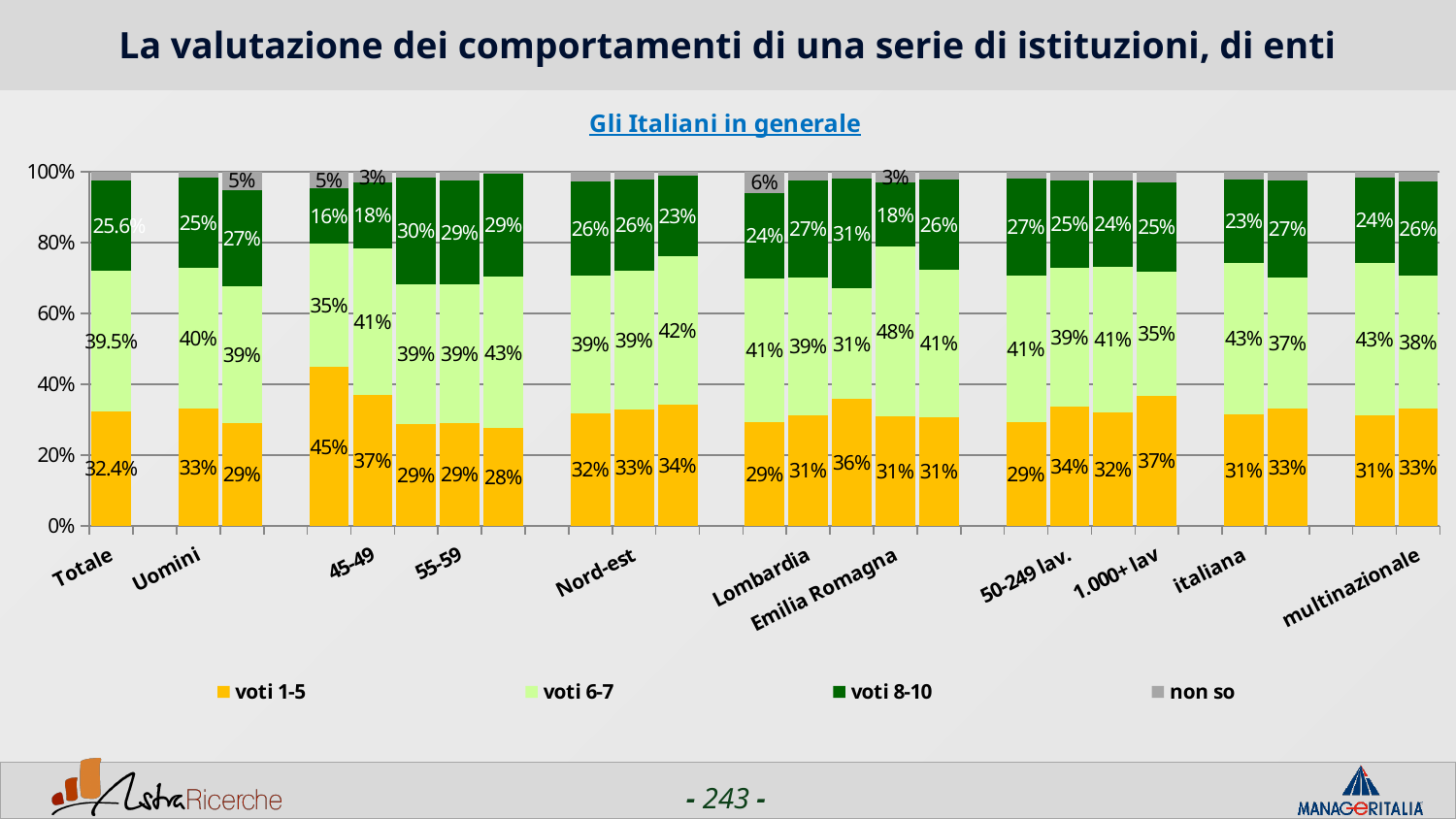
What kind of chart is shown on the slide? Stacked bar chart What is the value of 'voti 6-7' for Uomini? 40% What is the value of 'voti 1-5' for Totale? 32.4% How many series does the legend list? 4 What are the four legend entries of the chart? voti 1-5, voti 6-7, voti 8-10, non so For Totale, which is larger: 'voti 6-7' or 'voti 1-5'? voti 6-7 What is the value of 'voti 8-10' for Totale? 25.6% For Uomini, what is the difference between 'voti 6-7' and 'voti 1-5'? 7 percentage points What is the value of 'voti 6-7' for Totale? 39.5% What is the subtitle shown above the chart? Gli Italiani in generale What is the value of 'voti 1-5' for Uomini? 33% What is the value of 'voti 8-10' for Uomini? 25%